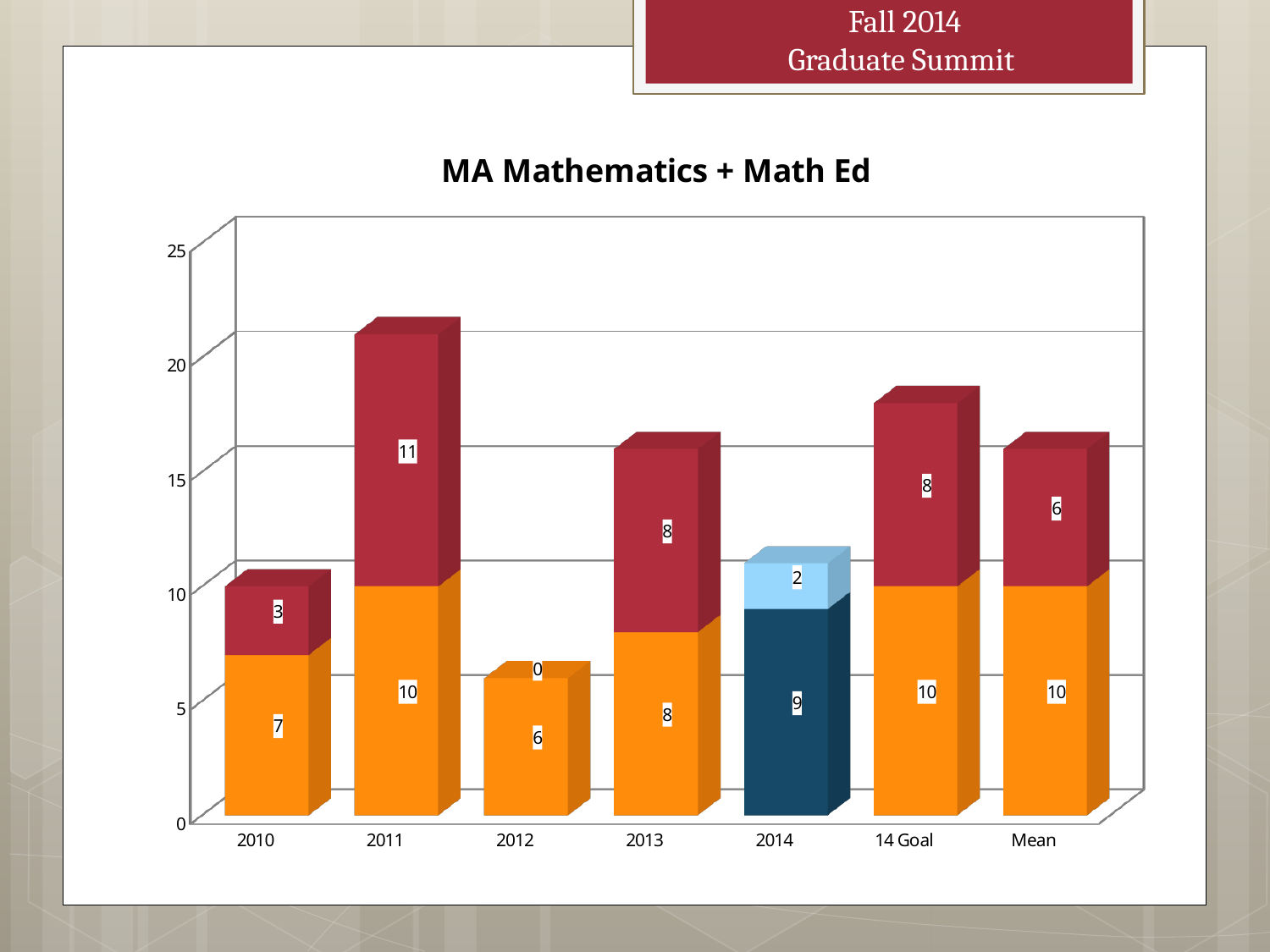
What is the title of the chart? MA Mathematics + Math Ed What is the total of the stacked bar for 14 Goal? 18 What is the value of the top segment of the 2011 bar? 11 Which category has the highest total bar? 2011 How many categories are shown on the x axis? 7 What kind of chart is shown on the slide? Stacked bar chart What is the value of the bottom segment of the 2010 bar? 7 What is the difference between the top segment values for 2013 and 2014? 6 What is the value of the bottom segment of the 2014 bar? 9 Which category has the lowest total bar? 2012 What is the total of the stacked bar for 2011? 21 What is the value of the top segment of the 2012 bar? 0